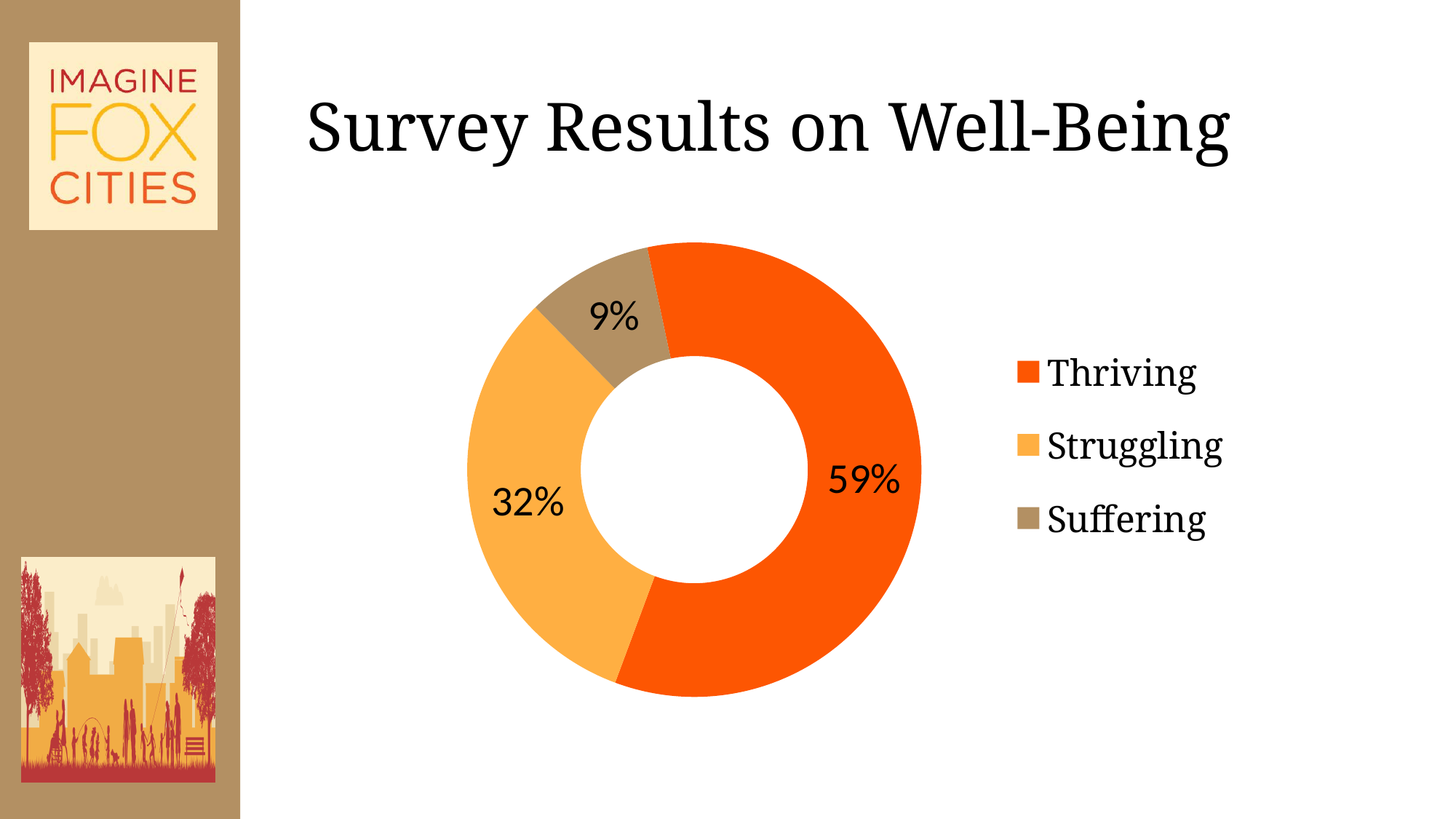
Which category has the largest share of the chart? Thriving What percentage of respondents are Thriving? 59% What kind of chart is shown on the slide? Doughnut chart Which category is shown in the brown/tan colour? Suffering What is the title of the slide? Survey Results on Well-Being What percentage of respondents are Suffering? 9% What is the difference in percentage points between Struggling and Suffering? 23 Which is larger, the share for Struggling or the share for Suffering? Struggling How many categories does the chart show? 3 What is the difference in percentage points between Thriving and Struggling? 27 What percentage of respondents are Struggling? 32% Which category has the smallest share of the chart? Suffering